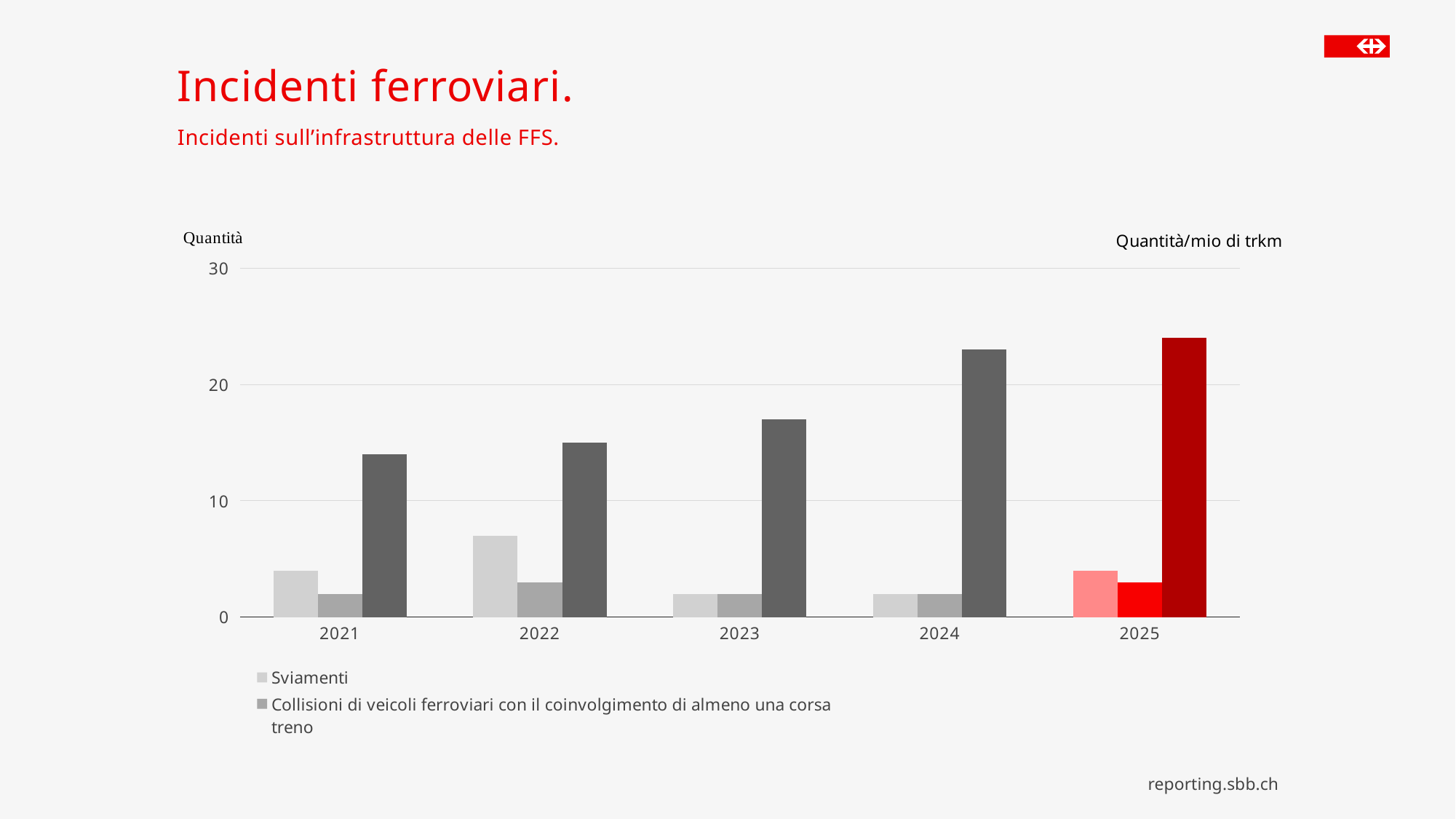
Is the value of the tallest (dark) bar for 2021 greater or less than 10? greater In which year is the Sviamenti bar the highest? 2022 Is the value of the tallest (dark) bar for 2023 greater or less than 20? less How many years are shown on the x axis of the chart? 5 Which is larger, the Sviamenti value for 2022 or the Sviamenti value for 2021? 2022 What is the title of the slide containing the chart? Incidenti ferroviari. Do the tallest (dark) bars rise or fall from 2021 to 2025? rise How many series does the chart's legend list? 2 Is the Sviamenti value for 2022 greater or less than 10? less What label is shown above the right-hand axis of the chart? Quantità/mio di trkm What kind of chart is shown on the slide? bar chart